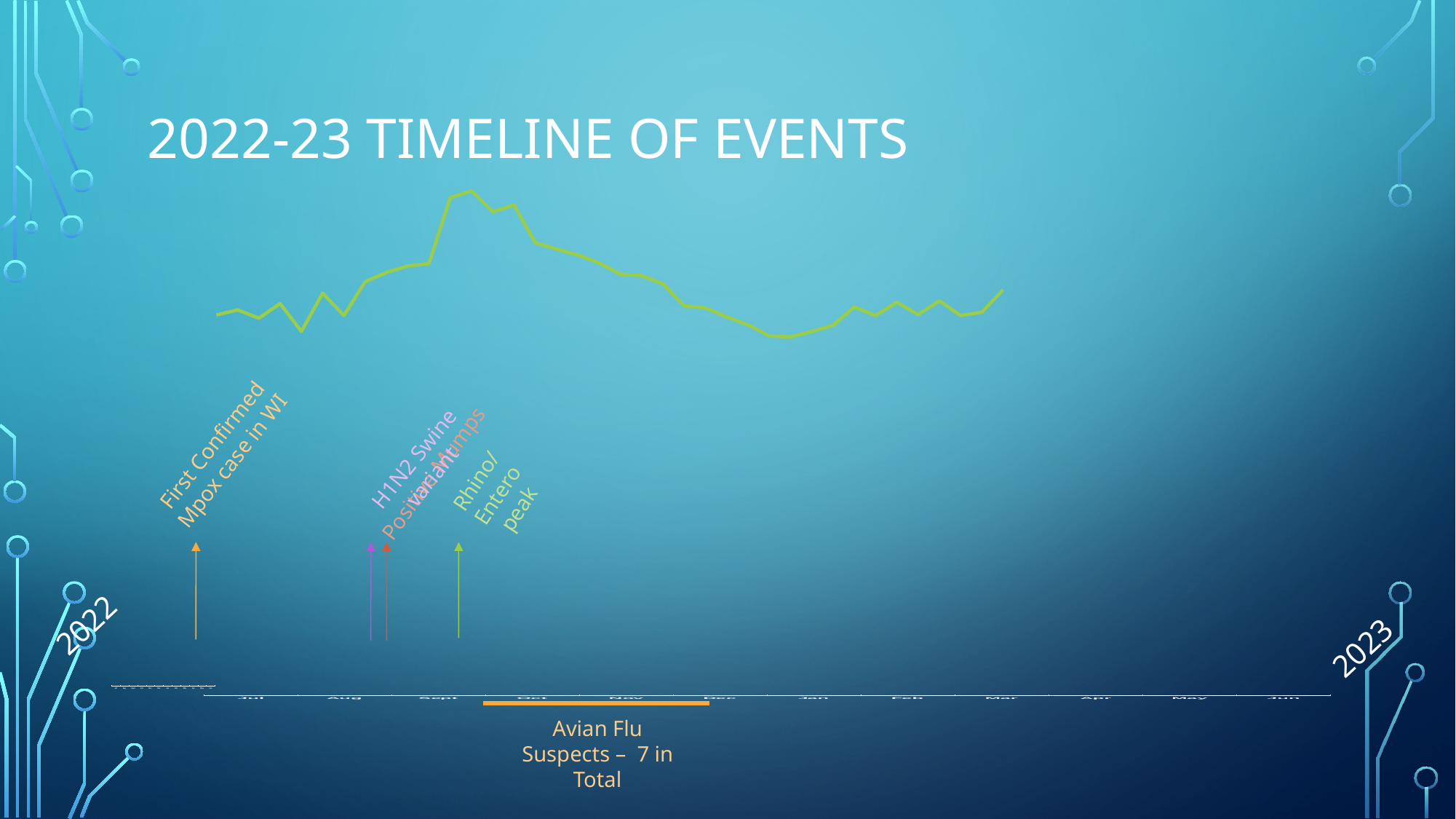
Does the plotted line rise or fall between Jul and Sept? rise Is the plotted line higher in Sept or in Jan? Sept Does the plotted line rise or fall between Oct and Dec? fall What is the title of the slide containing the chart? 2022-23 Timeline of Events According to the annotation under the x axis, how many Avian Flu suspects were there in total? 7 In which month does the plotted line end? Mar Is the plotted line higher in Jul or in Sept? Sept What kind of chart is shown on the slide? line chart How many month labels are shown along the x axis of the chart? 12 Is the plotted line higher in Nov or in Jan? Nov